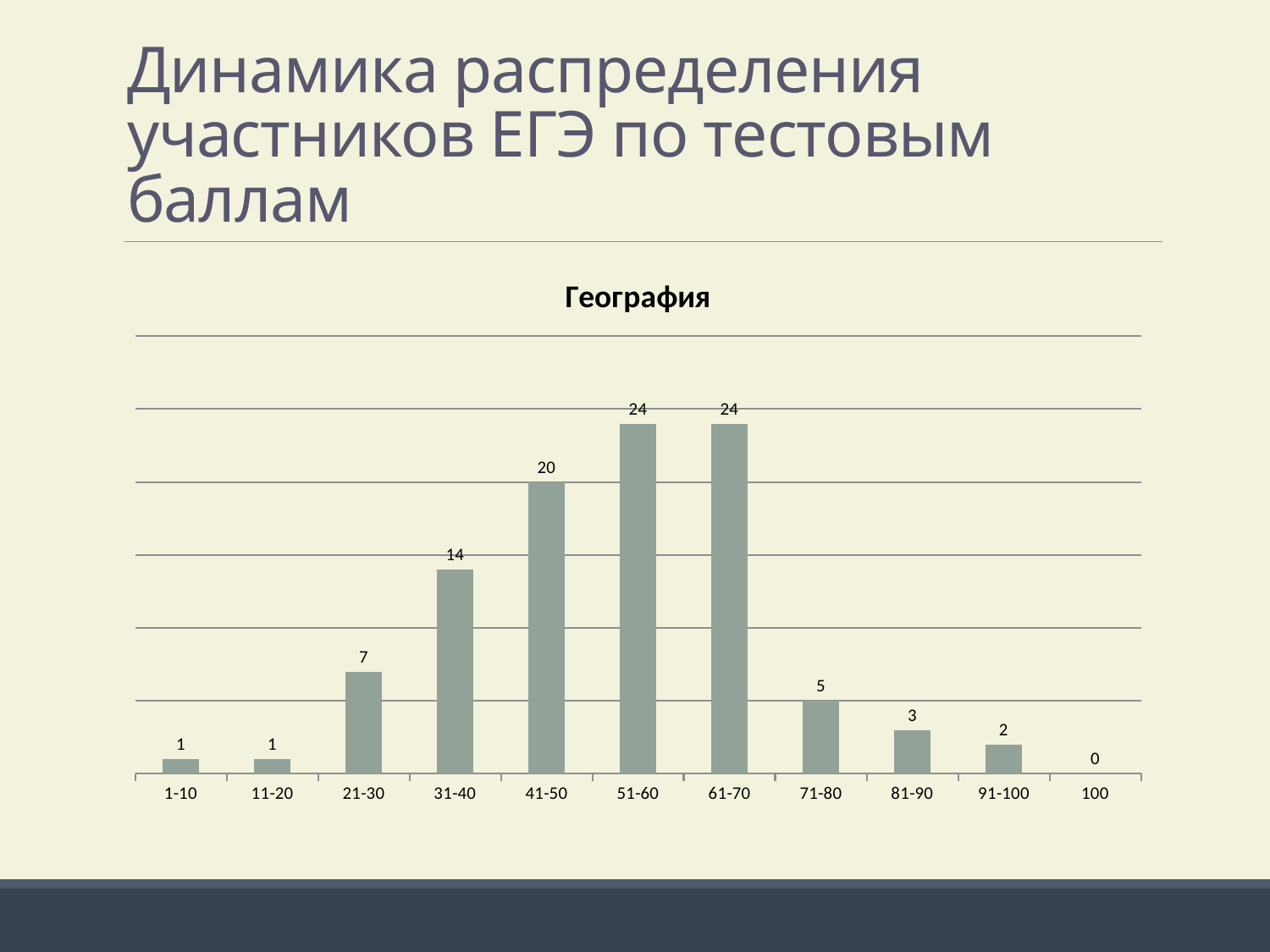
Do the values rise or fall from 61-70 to 100 along the x axis? fall What is the value for the 71-80 category? 5 What is the value for the 21-30 category? 7 What is the value for the 91-100 category? 2 Which category has the lowest value? 100 Which is larger, the value for 31-40 or the value for 81-90? 31-40 How many categories are shown on the x axis? 11 What is the value for the 41-50 category? 20 What is the difference between the values for 41-50 and 31-40? 6 What kind of chart is shown on the slide? bar chart What is the difference between the values for 51-60 and 71-80? 19 What is the title of the chart? География